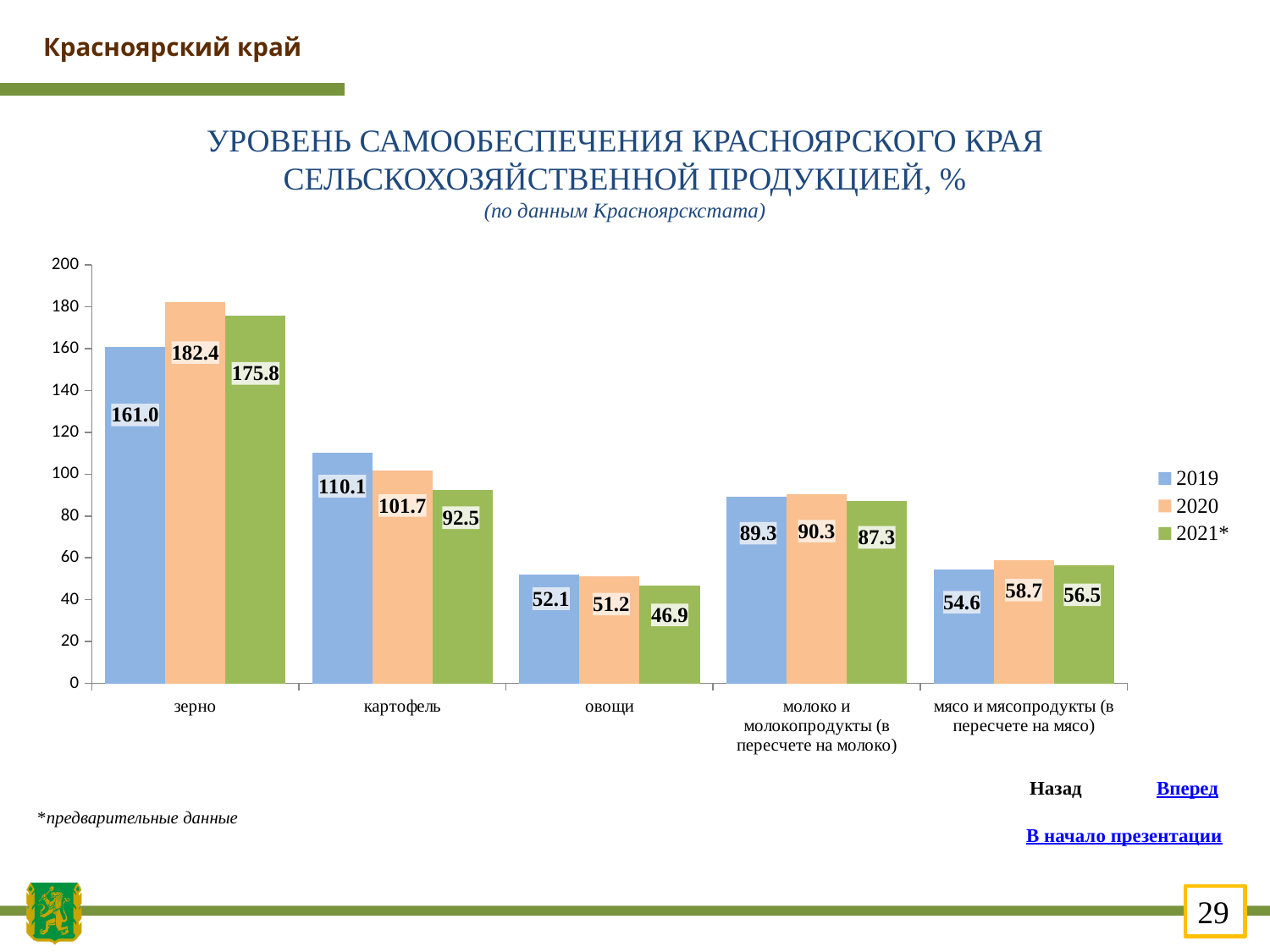
What is the value for зерно in 2020? 182.4 What is the value for овощи in 2021*? 46.9 What is the difference between the 2020 and 2019 values for зерно? 21.4 How many categories are shown on the x axis? 5 Which is larger for мясо и мясопродукты (в пересчете на мясо): the 2020 value or the 2019 value? 2020 Which category has the lowest value in 2019? овощи Which category has the highest value in 2021*? зерно How many series does the legend list? 3 What kind of chart is shown on the slide? bar chart Do the values for овощи rise or fall from 2019 to 2021*? fall What is the value for картофель in 2019? 110.1 Is the value for картофель in 2021* greater or less than 100? less